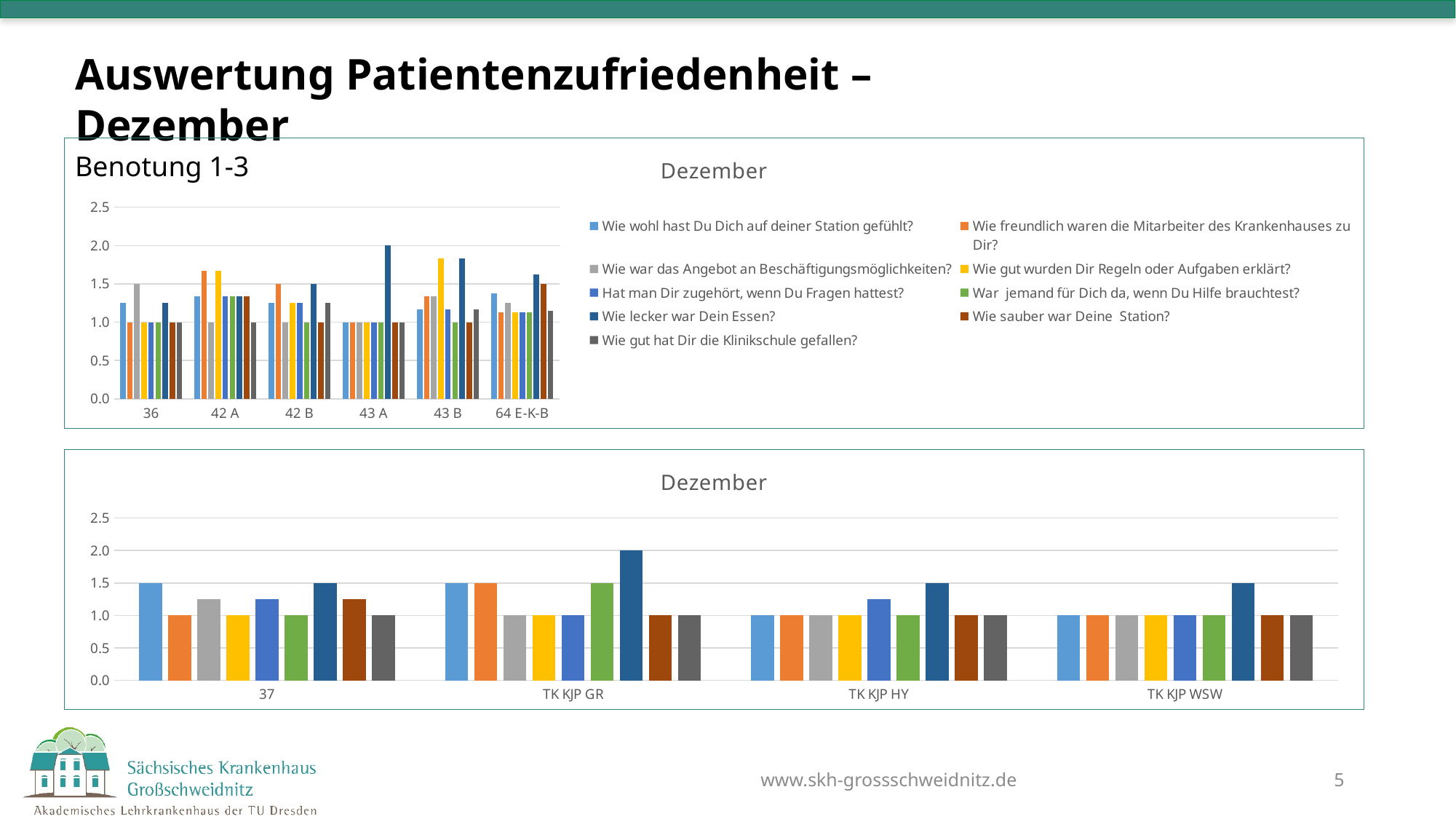
In the lower chart, what is the value for "Wie lecker war Dein Essen?" for TK KJP GR? 2.0 In the upper chart, what is the value for "Wie lecker war Dein Essen?" for 43 A? 2.0 In the lower chart, which category contains the tallest bar? TK KJP GR In the lower chart, what is the value for "Wie wohl hast Du Dich auf deiner Station gefühlt?" for 37? 1.5 In the lower chart, how many categories are shown on the x axis? 4 In the upper chart, is the value for "Wie gut wurden Dir Regeln oder Aufgaben erklärt?" for 43 B greater or less than 1.5? greater What kind of chart is the upper chart titled "Dezember"? bar chart How many series does the legend of the upper chart list? 9 In the lower chart, what is the difference between "Wie lecker war Dein Essen?" and "Wie sauber war Deine Station?" for TK KJP GR? 1.0 In the lower chart, is the value for "Hat man Dir zugehört, wenn Du Fragen hattest?" for TK KJP HY greater or less than 1.5? less In the lower chart, which has the larger value for "Wie wohl hast Du Dich auf deiner Station gefühlt?": 37 or TK KJP HY? 37 In the upper chart, how many station categories are shown on the x axis? 6